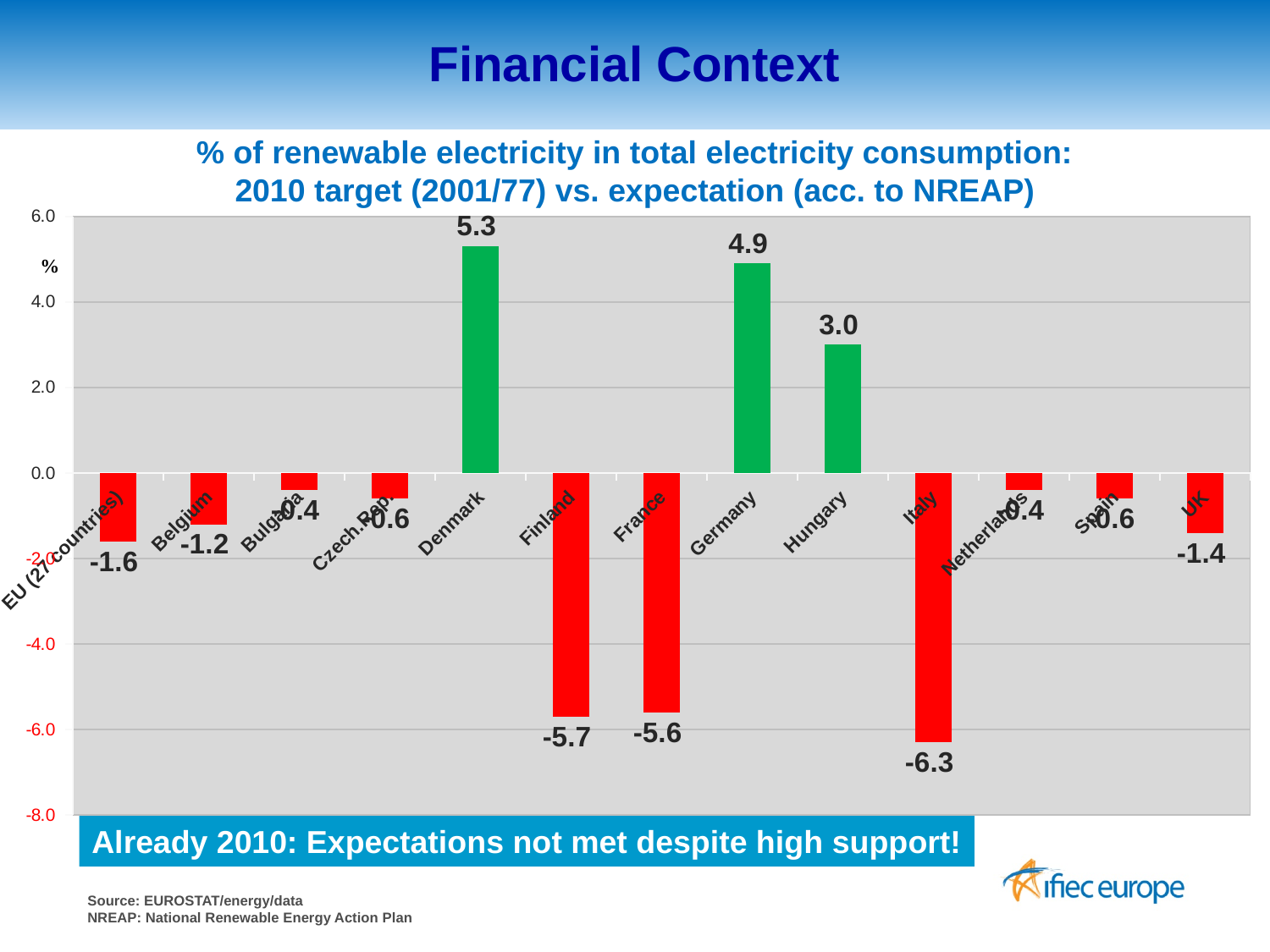
Is the value for Italy greater or less than -6.0? less How many bars are coloured green? 3 What kind of chart is shown? bar chart Which country has the lowest value? Italy How many countries/categories are shown on the x axis? 13 What is the value for EU (27 countries)? -1.6 Which has the larger value, Germany or Hungary? Germany What is the value for Germany? 4.9 What is the difference between the values for Denmark and Germany? 0.4 What is the value for Denmark? 5.3 What is the value for Italy? -6.3 Which country has the highest value? Denmark